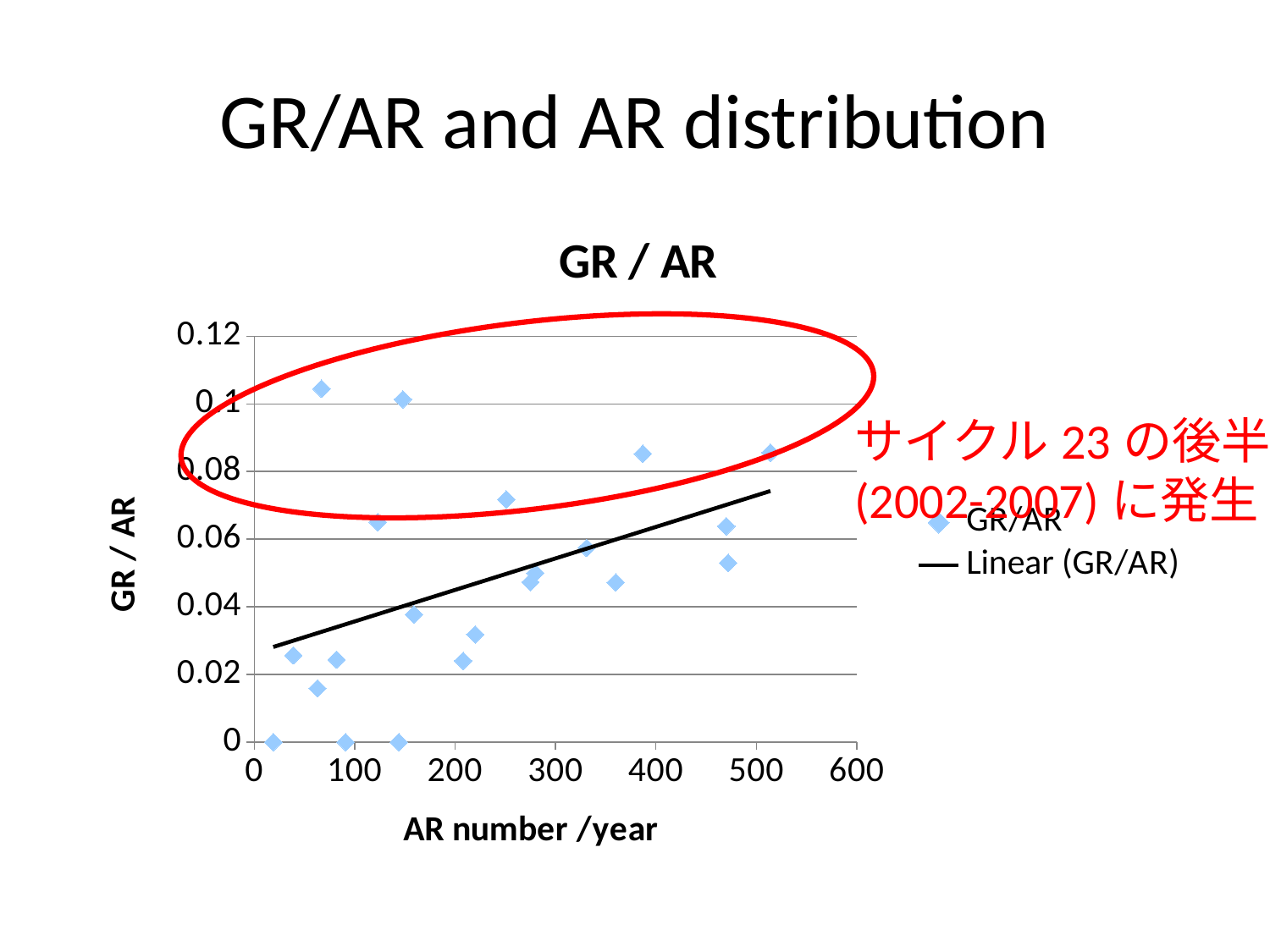
Is the GR/AR value for the point at an AR number of about 250 greater or less than 0.06? greater Is the value of the linear trendline at an AR number of 500 greater or less than 0.06? greater Is the GR/AR value for the point at an AR number of about 360 greater or less than 0.06? less Does the linear trendline rise or fall as AR number increases? rises What is the lowest GR/AR value plotted on the chart? 0 What is the title of the chart? GR / AR What kind of chart is shown on the slide? scatter chart How many entries does the chart legend list? 2 What is the title of the horizontal axis? AR number /year